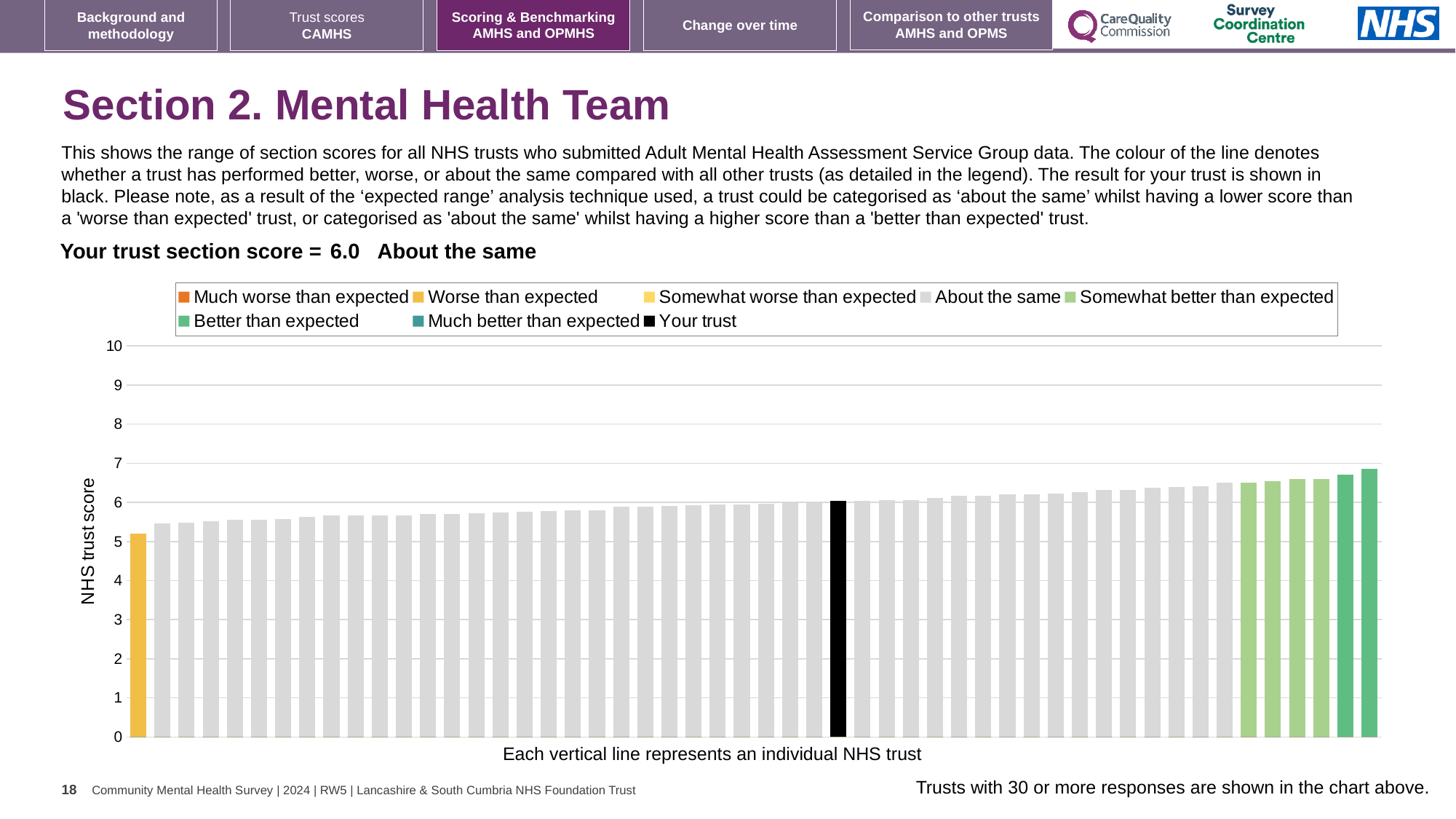
Which bar is the lowest in the chart: the leftmost yellow bar or the black bar for your trust? the leftmost yellow bar How many bars in the chart are coloured yellow? 1 Do the bar values rise or fall from left to right across the chart? rise How many entries does the chart legend list? 8 Is the value of the rightmost bar greater or less than 6? greater How is your trust's section score categorised compared with other trusts? About the same What is the label on the vertical axis of the chart? NHS trust score What kind of chart is shown on the slide? Bar chart What is the section score for your trust shown on the slide? 6.0 Is the value of the black bar (your trust) greater or less than 5? greater Is the value of the rightmost bar greater or less than 7? less